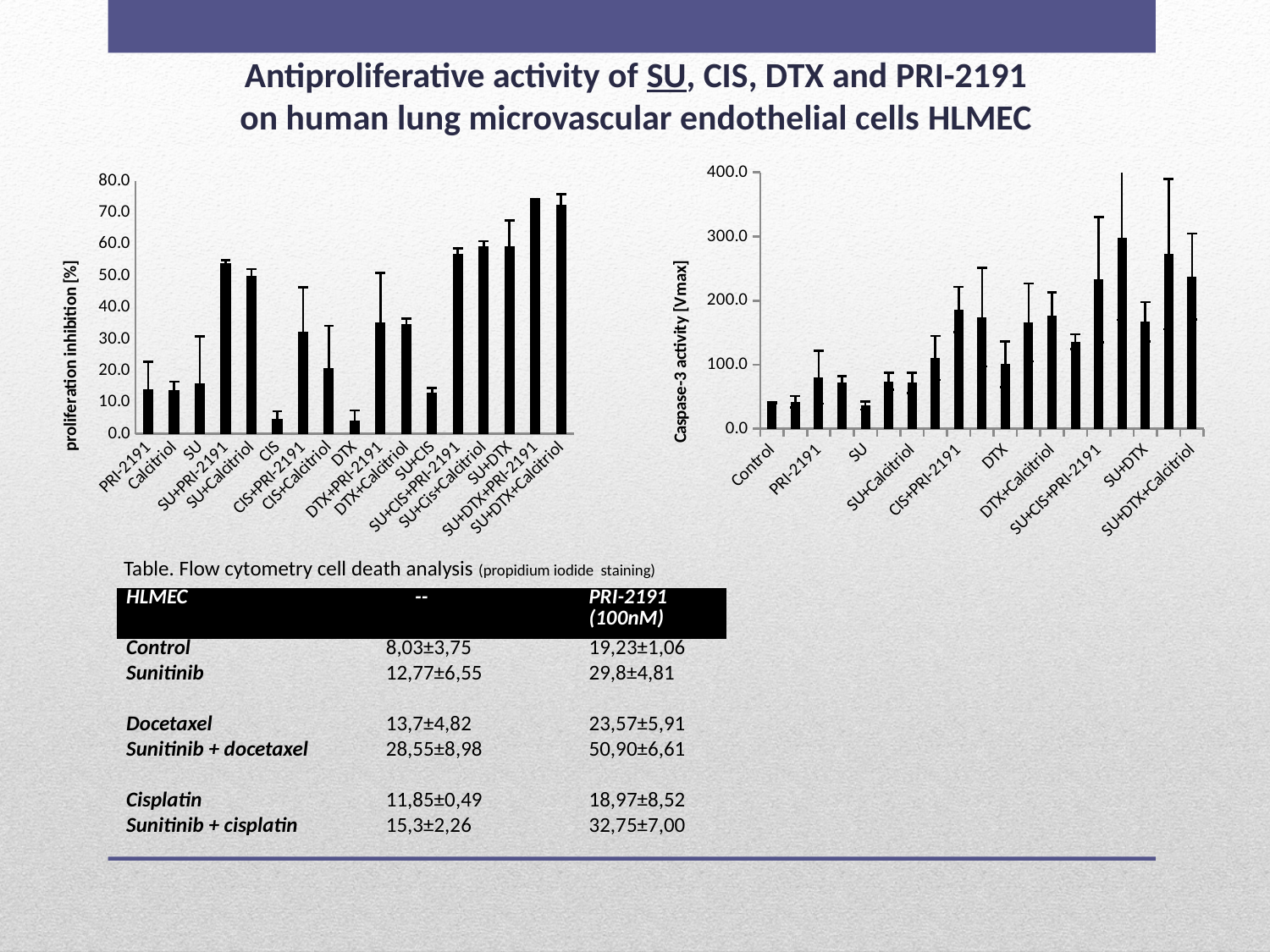
What type of chart is the left chart showing proliferation inhibition? bar chart What is the y-axis label of the right chart? Caspase-3 activity [Vmax] On the left chart (proliferation inhibition), which is larger, the value for SU+PRI-2191 or the value for CIS? SU+PRI-2191 On the left chart (proliferation inhibition), is the value for SU+DTX+PRI-2191 greater or less than 70? greater How many categories are plotted on the left chart (proliferation inhibition)? 17 On the left chart (proliferation inhibition), is the value for SU+CIS greater or less than 20? less On the left chart (proliferation inhibition), is the value for CIS greater or less than 10? less What is the y-axis label of the left chart? proliferation inhibition [%] On the left chart (proliferation inhibition), which is larger, the value for SU+CIS or the value for SU+CIS+PRI-2191? SU+CIS+PRI-2191 What type of chart is the right chart showing Caspase-3 activity? bar chart